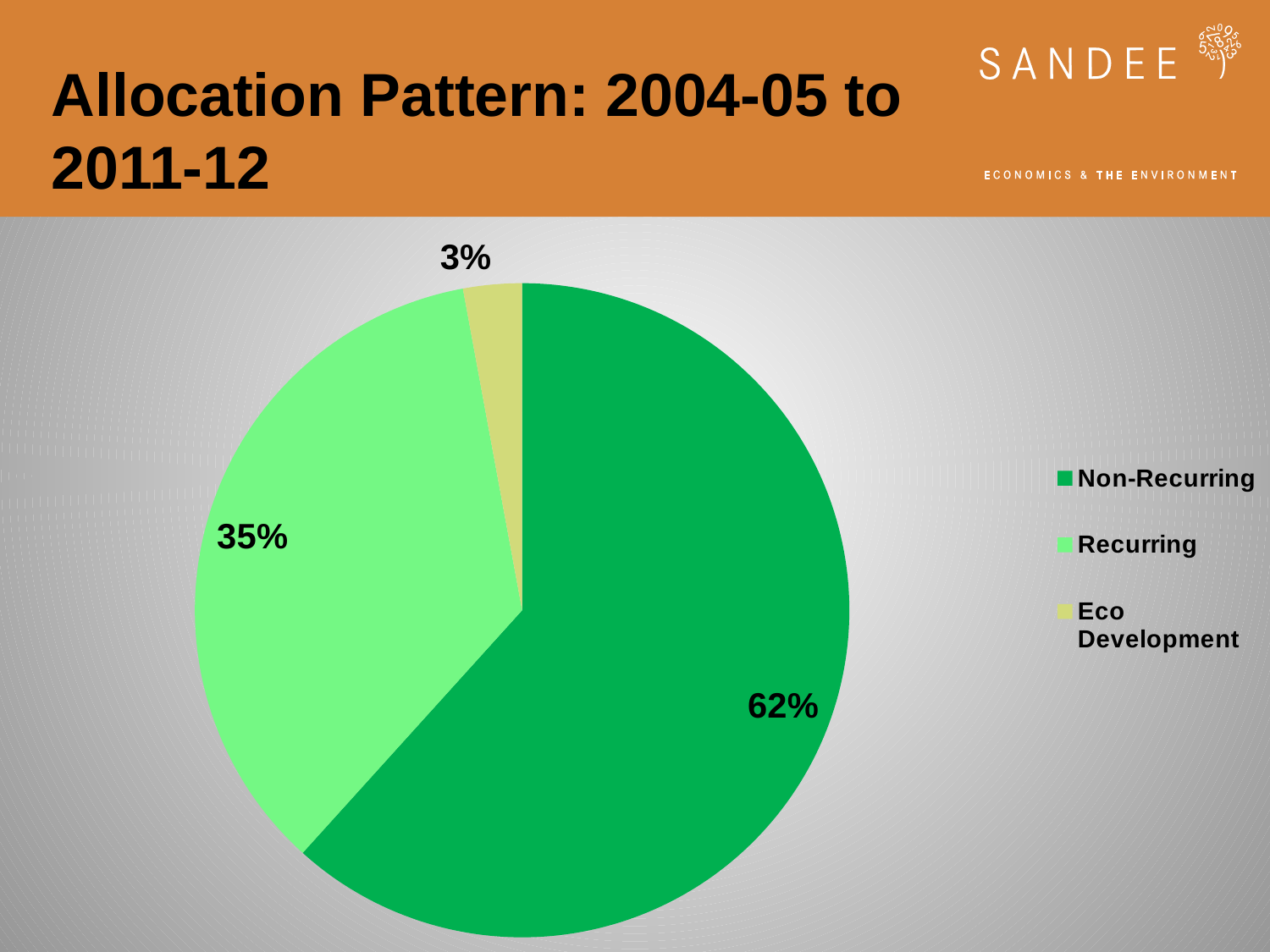
What is the difference in percentage points between the Recurring and Eco Development slices? 32 Which category has the largest slice of the pie? Non-Recurring Which is larger, the Recurring slice or the Eco Development slice? Recurring How many categories does the pie chart show? 3 What share of the pie does Non-Recurring take? 62% What share of the pie does Recurring take? 35% What is the title of the slide containing the pie chart? Allocation Pattern: 2004-05 to 2011-12 What share of the pie does Eco Development take? 3% How many entries does the legend list? 3 What is the difference in percentage points between the Non-Recurring and Recurring slices? 27 What kind of chart is shown on the slide? pie chart Which category has the smallest slice of the pie? Eco Development